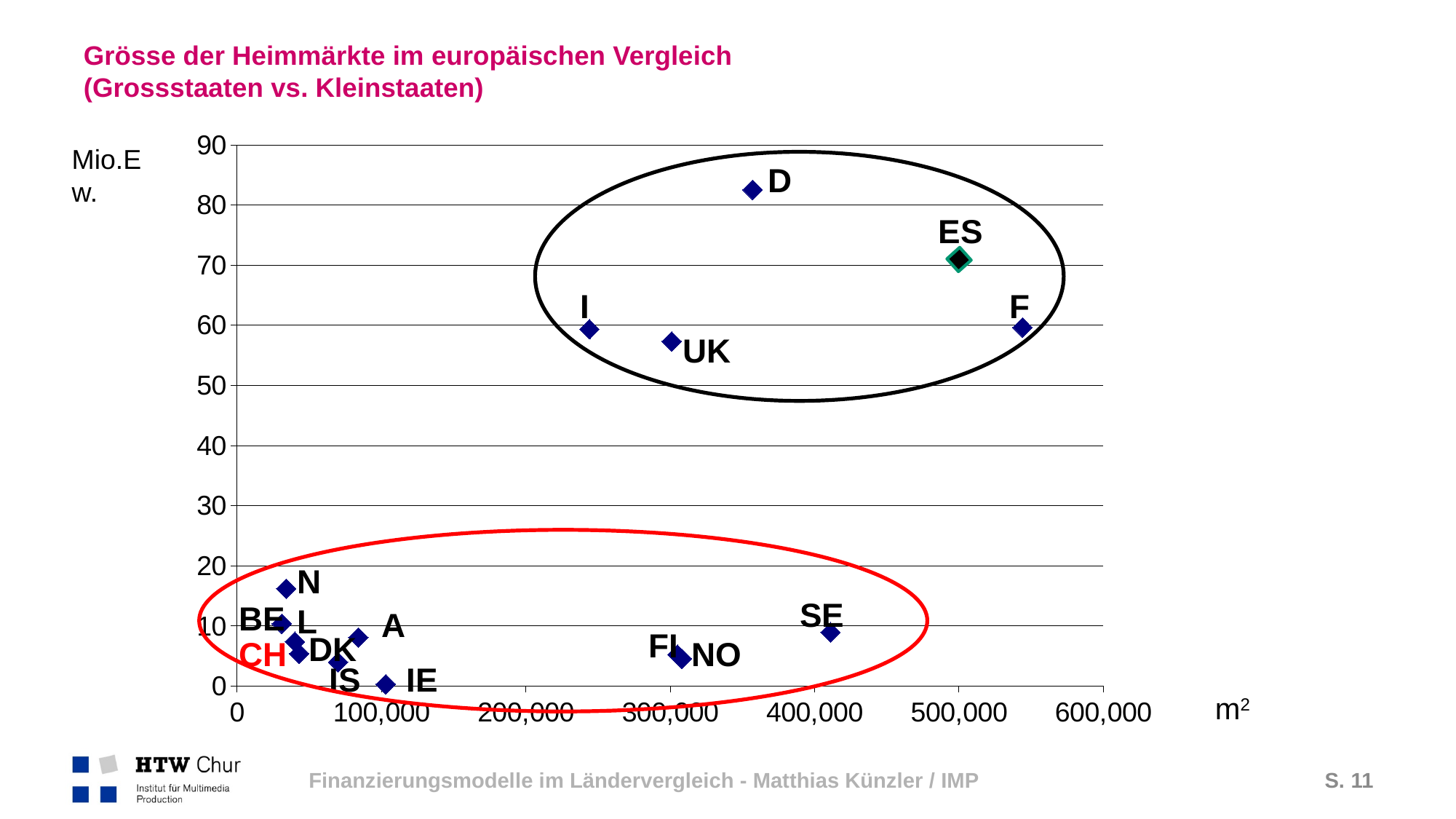
Is the value for D on the vertical axis greater or less than 70? greater Is the value for F on the vertical axis greater or less than 70? less Is the value for N on the vertical axis greater or less than 10? greater Which has the higher value on the vertical axis, N or IE? N What is the title of the chart? Grösse der Heimmärkte im europäischen Vergleich (Grossstaaten vs. Kleinstaaten) Which country has the highest value on the vertical axis (Mio. Ew.)? D What kind of chart is shown on the slide? scatter chart What unit is shown on the horizontal axis? m² Which has the higher value on the vertical axis, D or UK? D